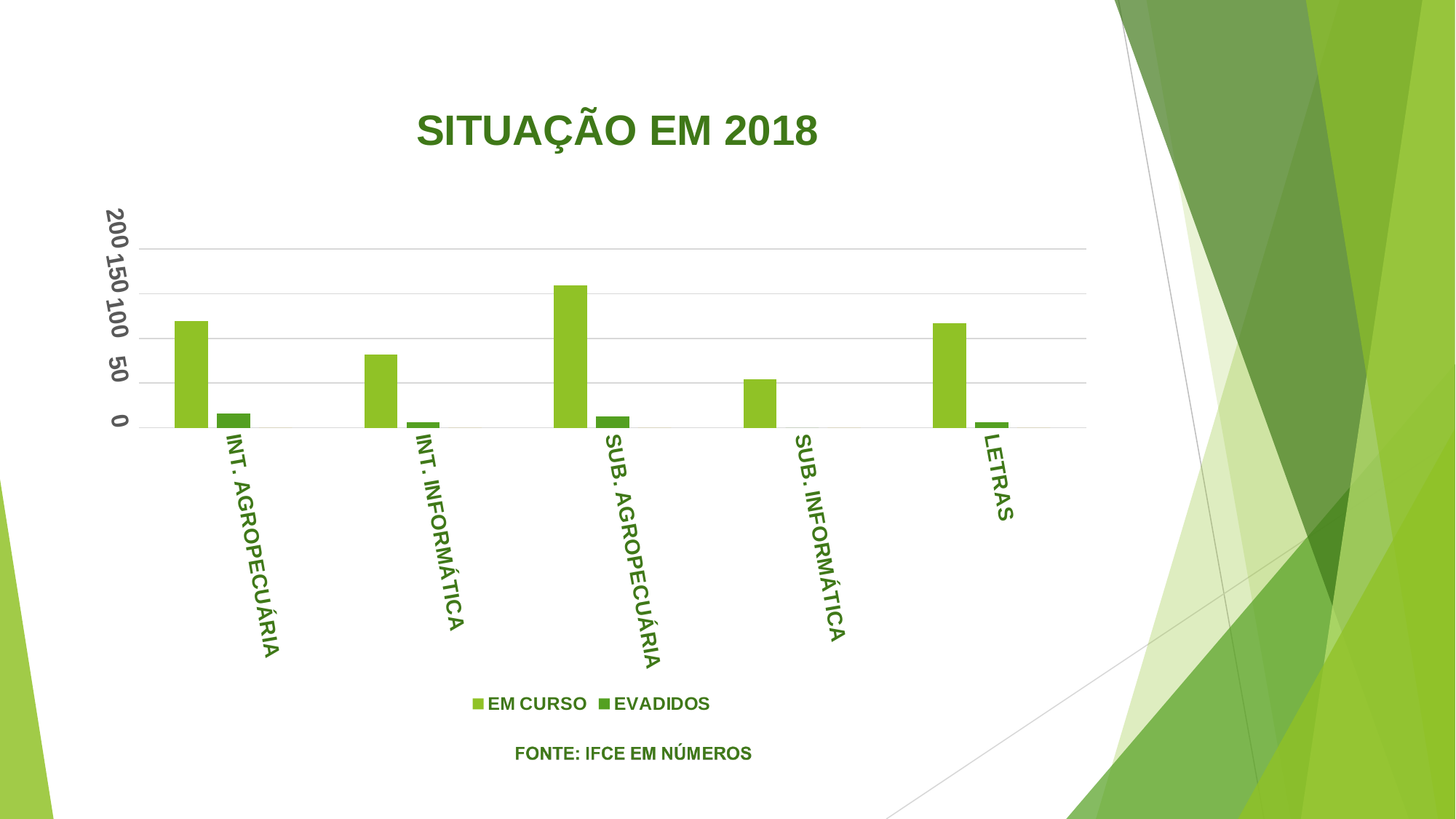
How many series does the legend list? 2 Is the EVADIDOS value for INT. AGROPECUÁRIA greater or less than 50? less What is the title of the chart? SITUAÇÃO EM 2018 Is the EM CURSO value for INT. INFORMÁTICA greater or less than 100? less Which is larger, the EM CURSO value for SUB. AGROPECUÁRIA or for SUB. INFORMÁTICA? SUB. AGROPECUÁRIA Which category has the highest EM CURSO value? SUB. AGROPECUÁRIA Is the EM CURSO value for SUB. AGROPECUÁRIA greater or less than 150? greater Which is larger, the EM CURSO value for INT. AGROPECUÁRIA or for INT. INFORMÁTICA? INT. AGROPECUÁRIA How many categories are shown on the x axis? 5 Which category has the lowest EM CURSO value? SUB. INFORMÁTICA What kind of chart is shown on the slide? Bar chart